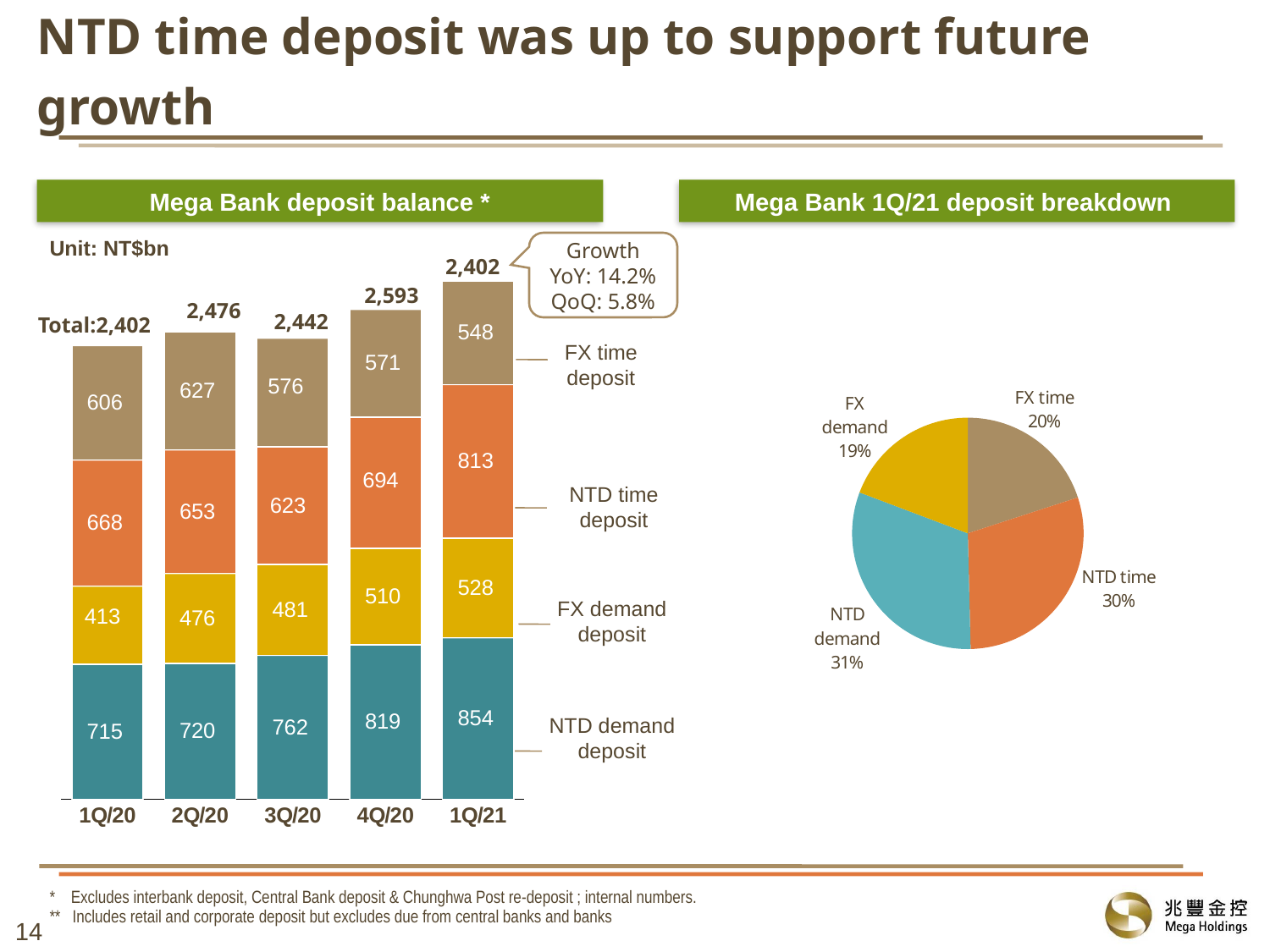
What kind of chart is the Mega Bank deposit balance chart? Stacked bar chart In the Mega Bank deposit balance chart, what is the NTD time deposit value for 1Q/21? 813 In the Mega Bank deposit balance chart, which quarter has the highest NTD demand deposit? 1Q/21 In the Mega Bank deposit balance chart, does NTD demand deposit rise or fall from 1Q/20 to 1Q/21? Rise In the Mega Bank 1Q/21 deposit breakdown pie chart, what share does NTD demand represent? 31% In the Mega Bank deposit balance chart, by how much did NTD demand deposit increase from 1Q/20 to 1Q/21? 139 In the Mega Bank deposit balance chart, what is the FX demand deposit value for 4Q/20? 510 In the Mega Bank deposit balance chart, what is the total deposit balance for 4Q/20? 2,593 In the Mega Bank deposit balance chart, which is larger in 2Q/20: FX time deposit or NTD time deposit? NTD time deposit How many quarters are shown in the Mega Bank deposit balance chart? 5 How many deposit types are stacked in each bar of the Mega Bank deposit balance chart? 4 In the Mega Bank deposit balance chart, which quarter has the lowest FX demand deposit? 1Q/20